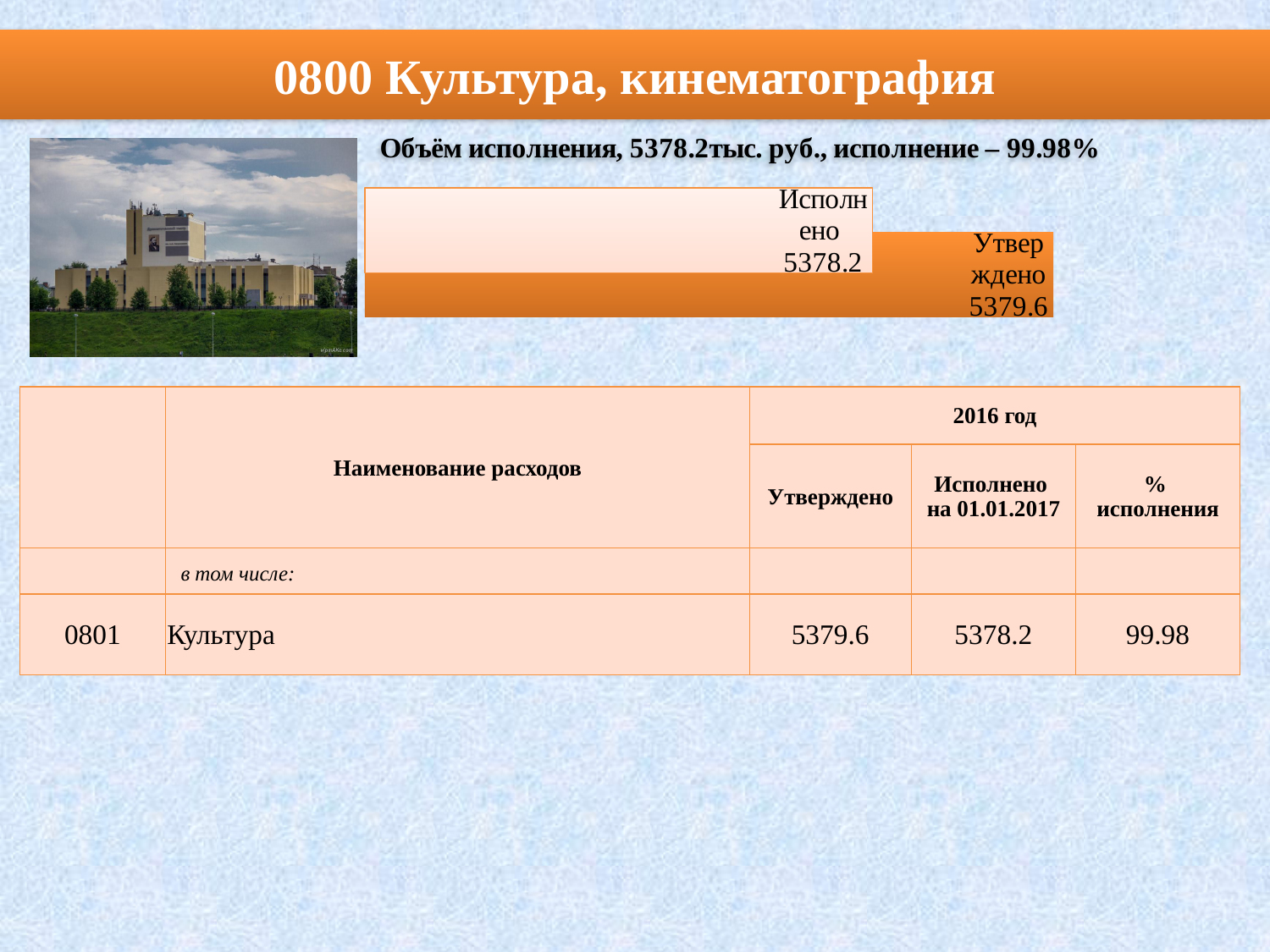
Which bar in the chart shows the largest value? Утверждено What is the value of the Исполнено bar in the chart? 5378.2 How many bars are plotted in the chart? 2 What colour are the bars in the chart? The Исполнено bar is light peach (cream) and the Утверждено bar is orange What is the value of the Утверждено bar in the chart? 5379.6 What is the difference between the Утверждено and Исполнено values in the chart? 1.4 Which bar in the chart has the higher value, Исполнено or Утверждено? Утверждено What type of chart is shown on the slide? bar chart Which bar in the chart shows the smallest value? Исполнено Are the bars in the chart oriented horizontally or vertically? horizontally